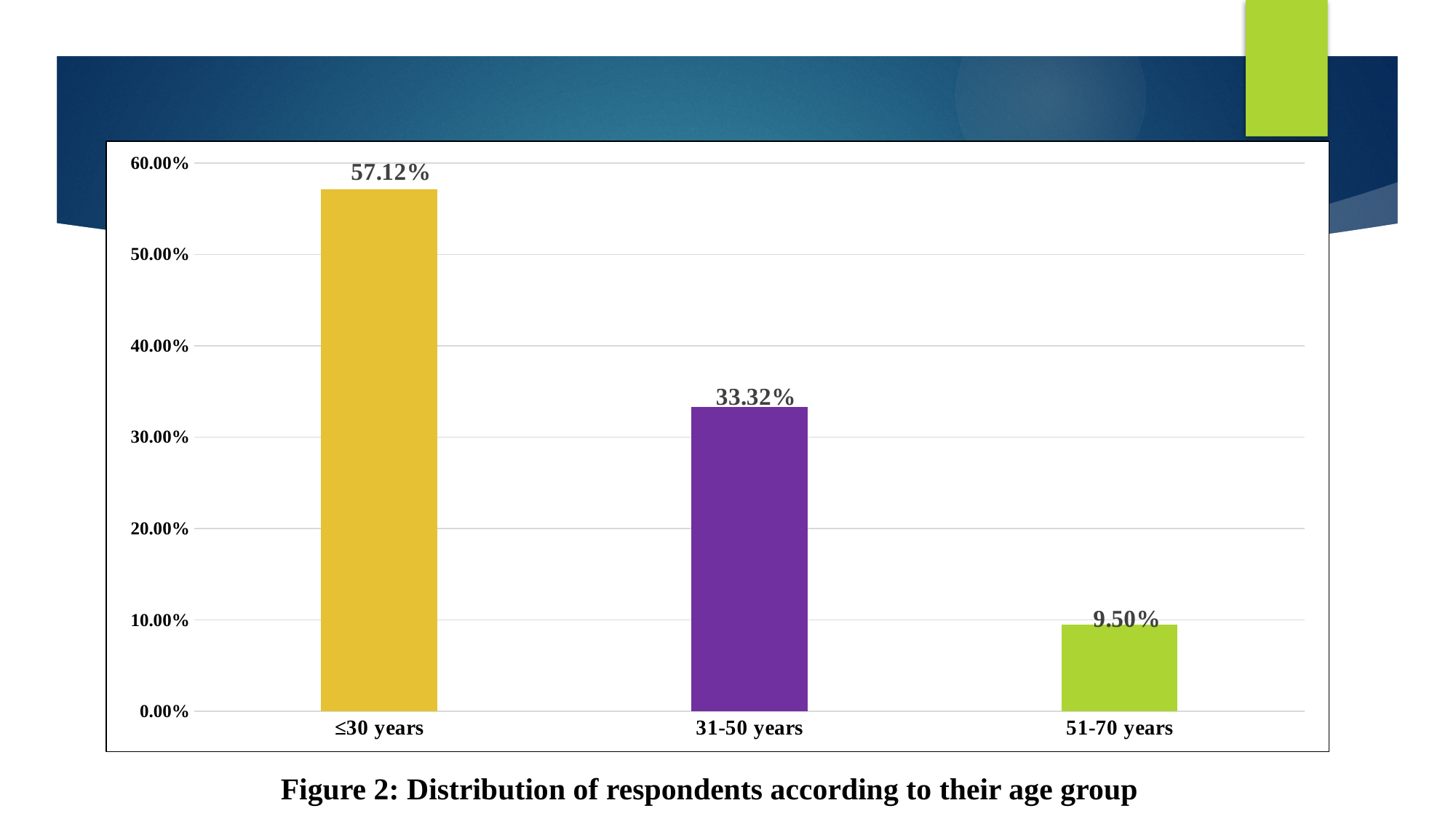
What is the value for the 31-50 years age group? 33.32% What kind of chart is shown on the slide? bar chart Which age group has the lowest share of respondents? 51-70 years What is the value for the ≤30 years age group? 57.12% Which age group has the highest share of respondents? ≤30 years Is the value for 31-50 years greater or less than 30.00%? greater What is the value for the 51-70 years age group? 9.50% How many age groups are shown in the chart? 3 What is the difference between the values for 31-50 years and 51-70 years? 23.82% Which is larger, the value for 31-50 years or the value for 51-70 years? 31-50 years What is the difference between the values for ≤30 years and 31-50 years? 23.80% Do the values rise or fall from left to right across the age groups? fall